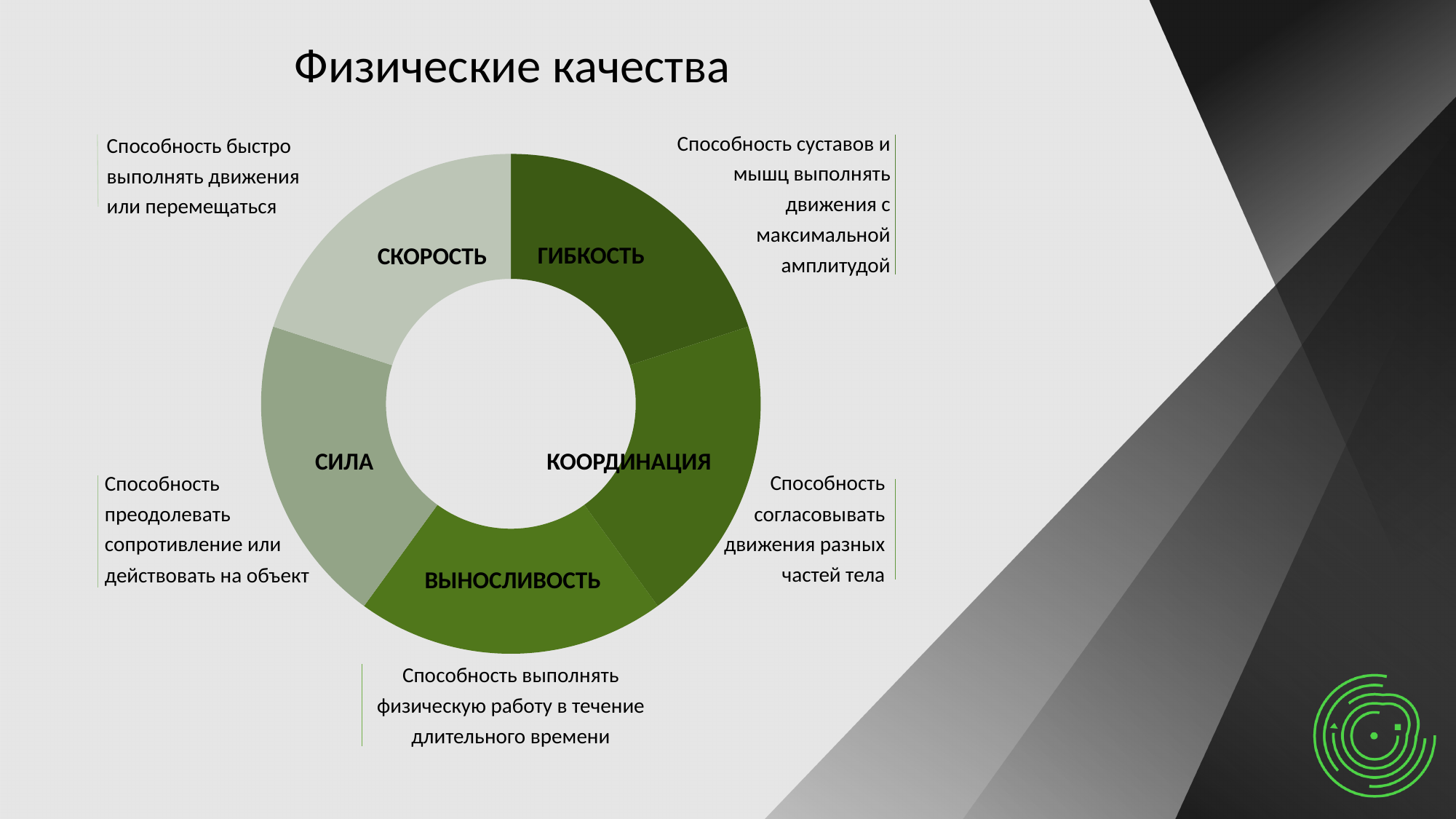
How many segments does the donut chart have? 5 Which segment of the donut chart is described as 'Способность суставов и мышц выполнять движения с максимальной амплитудой'? ГИБКОСТЬ Which segment of the donut chart is described as 'Способность выполнять физическую работу в течение длительного времени'? ВЫНОСЛИВОСТЬ Which segment of the donut chart is labelled between СКОРОСТЬ and ВЫНОСЛИВОСТЬ on the left side? СИЛА Which segment of the donut chart is described as 'Способность преодолевать сопротивление или действовать на объект'? СИЛА What is the title of the slide containing the donut chart? Физические качества What kind of chart is shown on the slide? Donut chart Which segment of the donut chart is described as 'Способность быстро выполнять движения или перемещаться'? СКОРОСТЬ Which segment of the donut chart is described as 'Способность согласовывать движения разных частей тела'? КООРДИНАЦИЯ